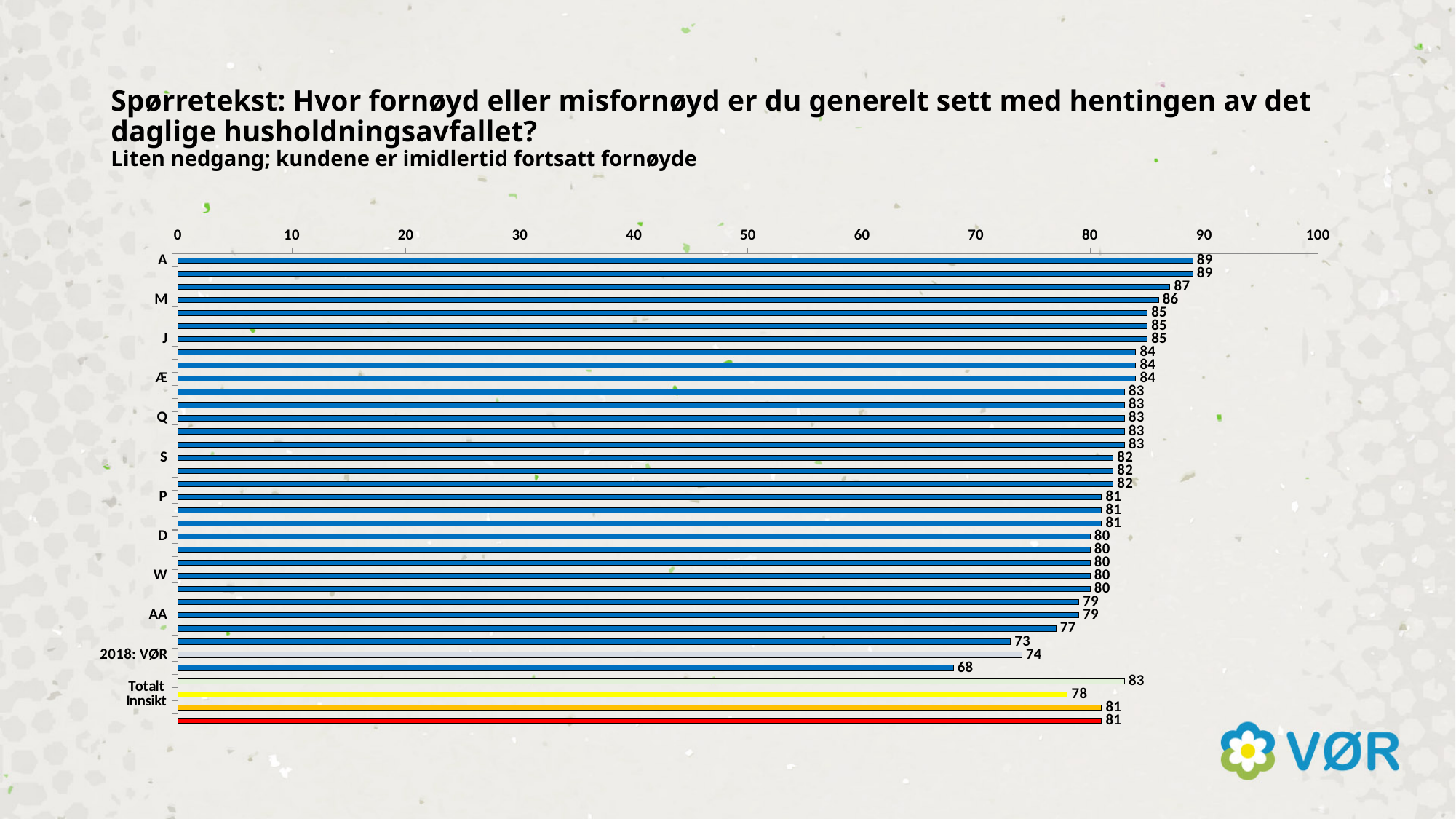
What is the maximum value shown on the horizontal axis? 100 Is the value for D greater or less than 90? less What is the value for A? 89 What is the value for AA? 79 Which has the larger value, M or AA? M What is the lowest value shown on the chart? 68 What is the highest value shown on the chart? 89 What is the difference between the value for A and the value for 2018: VØR? 15 What kind of chart is shown on the slide? bar chart What is the value for Q? 83 What is the value for 2018: VØR? 74 What is the value for M? 86